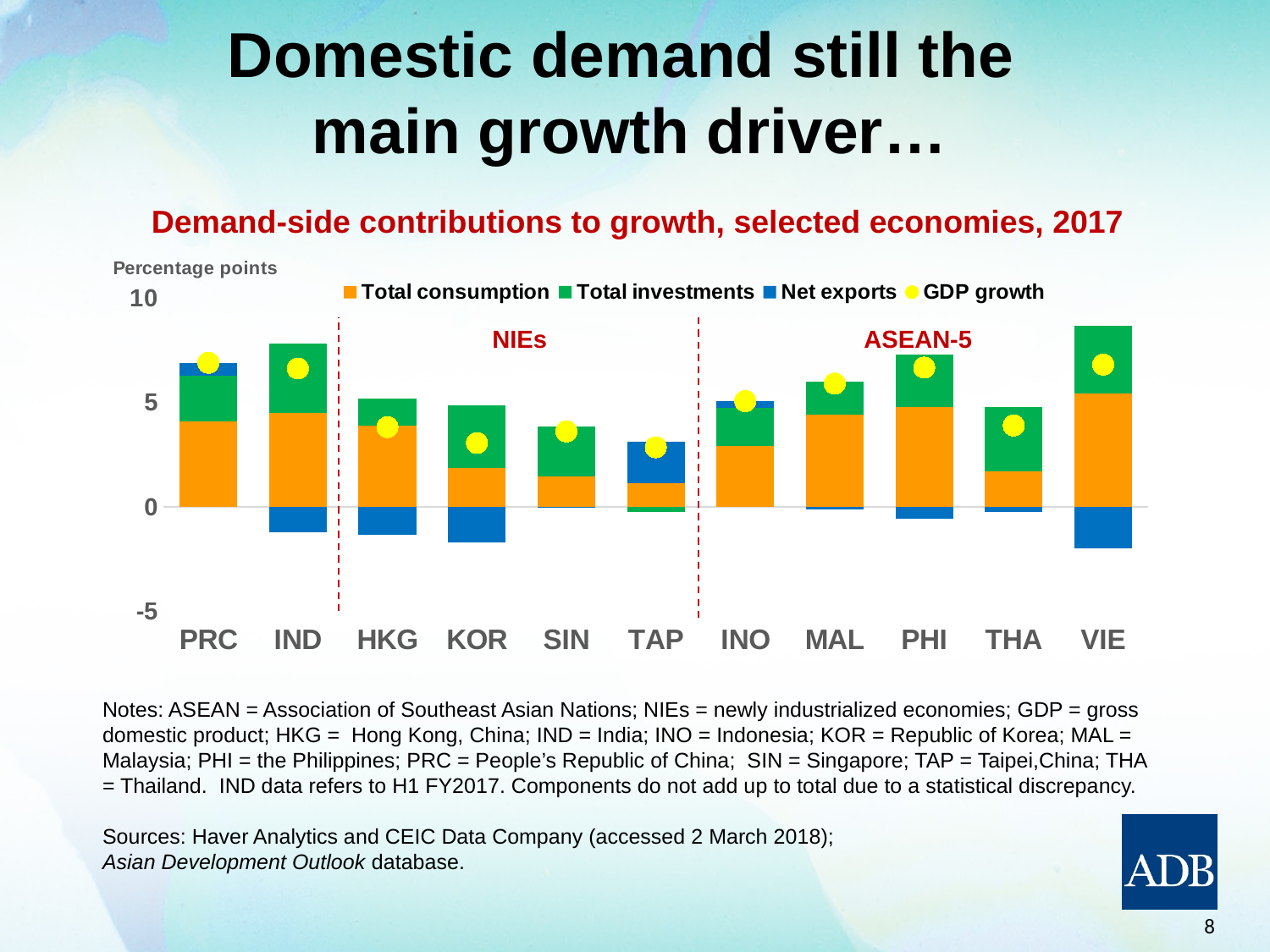
How many entries does the chart's legend list? 4 Is the Net exports value for KOR greater or less than 0? less Which economy has the highest Total consumption contribution? VIE Is the Net exports value for TAP greater or less than 0? greater Is the GDP growth value for TAP greater or less than 5? less Which is larger, the Total consumption contribution for PRC or for SIN? PRC What kind of chart is shown on the slide? Stacked bar chart What unit is shown on the chart's vertical axis label? Percentage points What is the title of the chart? Demand-side contributions to growth, selected economies, 2017 How many economies are shown on the x axis of the chart? 11